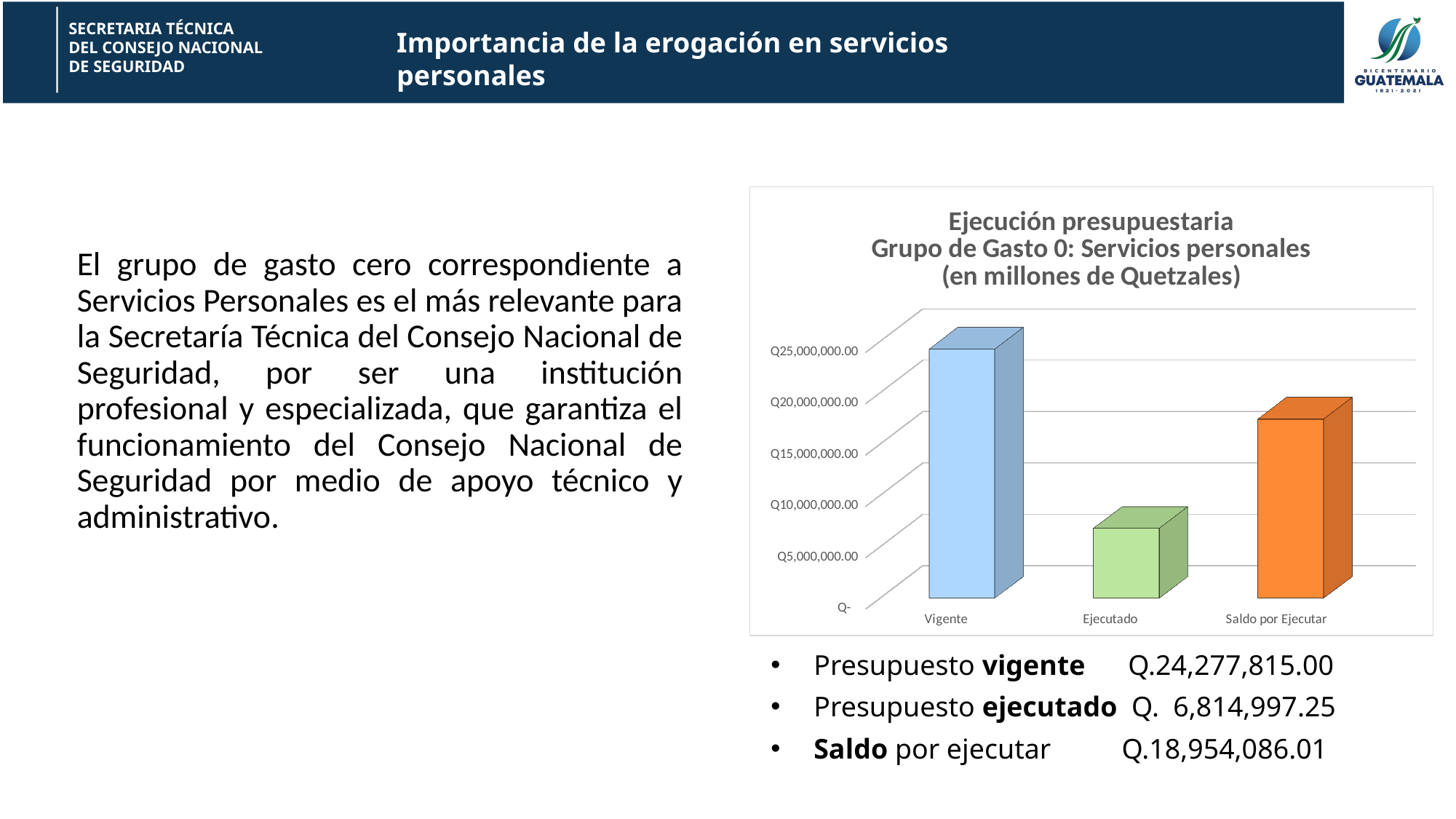
Which category has the lowest bar in the chart? Ejecutado Which category has the highest bar in the chart? Vigente Which is larger, the bar for Saldo por Ejecutar or the bar for Ejecutado? Saldo por Ejecutar What is the title of the chart? Ejecución presupuestaria Grupo de Gasto 0: Servicios personales (en millones de Quetzales) According to the slide, what is the value of the Presupuesto ejecutado? Q. 6,814,997.25 What kind of chart is shown on the slide? Bar chart Is the value for Ejecutado greater or less than Q10,000,000.00? less According to the slide, what is the value of the Presupuesto vigente? Q.24,277,815.00 Is the value for Saldo por Ejecutar greater or less than Q15,000,000.00? greater According to the slide, what is the Saldo por ejecutar? Q.18,954,086.01 Is the value for Vigente greater or less than Q20,000,000.00? greater How many categories are plotted in the chart? 3